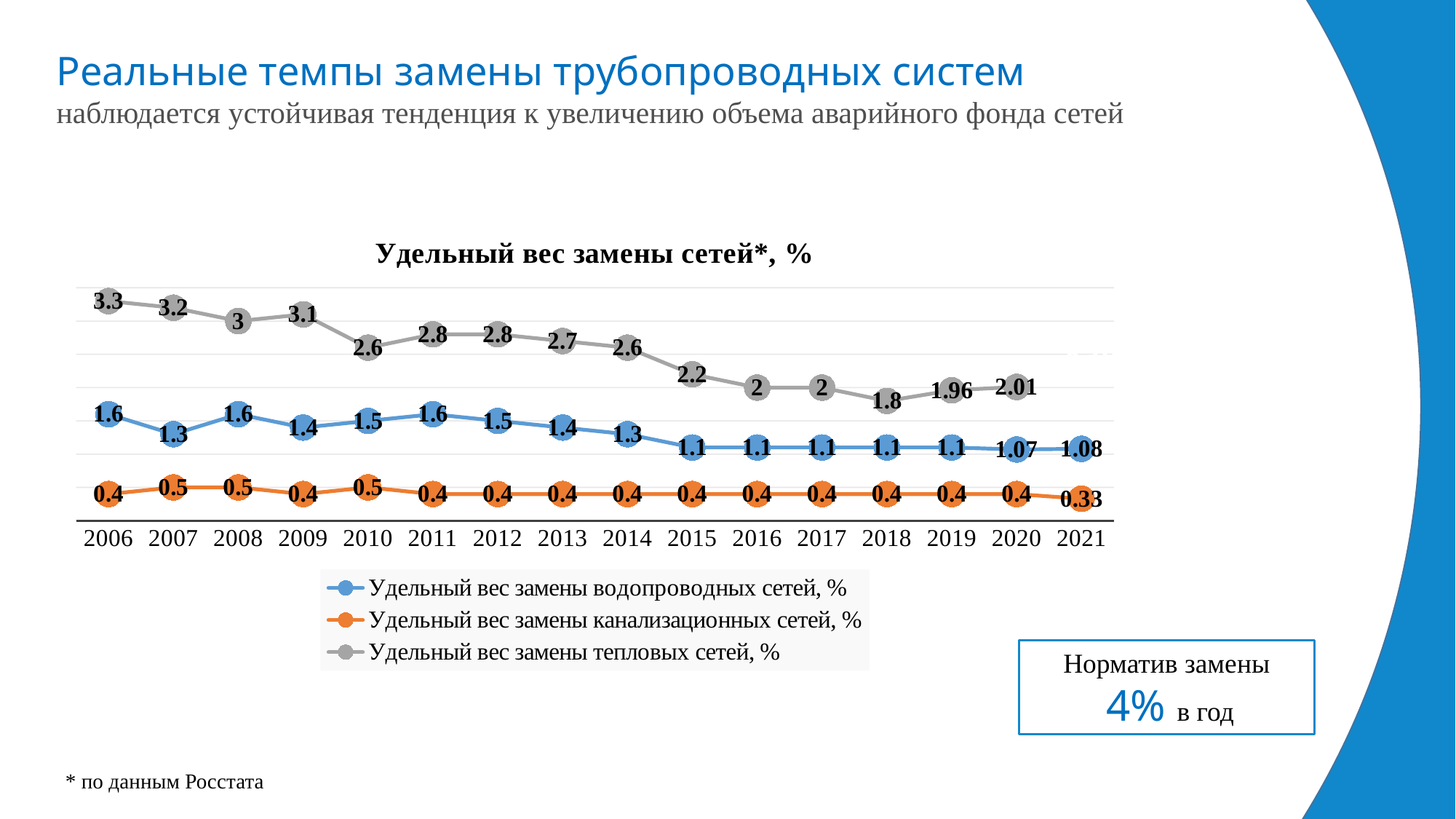
В каком году удельный вес замены тепловых сетей был наибольшим? 2006 Как в целом меняется удельный вес замены тепловых сетей с 2006 по 2020 год? снижается В каком году удельный вес замены тепловых сетей был наименьшим? 2018 Каков удельный вес замены тепловых сетей в 2006 году? 3.3 Каков удельный вес замены водопроводных сетей в 2020 году? 1.07 Каков удельный вес замены канализационных сетей в 2021 году? 0.33 На сколько удельный вес замены тепловых сетей в 2006 году больше, чем в 2018 году? 1.5 Сколько лет (точек по оси x) показано на диаграмме? 16 Что больше в 2015 году: удельный вес замены водопроводных сетей или тепловых сетей? тепловых сетей Сколько рядов данных перечислено в легенде диаграммы? 3 Каков удельный вес замены тепловых сетей в 2019 году? 1.96 Какой тип диаграммы показан на слайде? линейная диаграмма